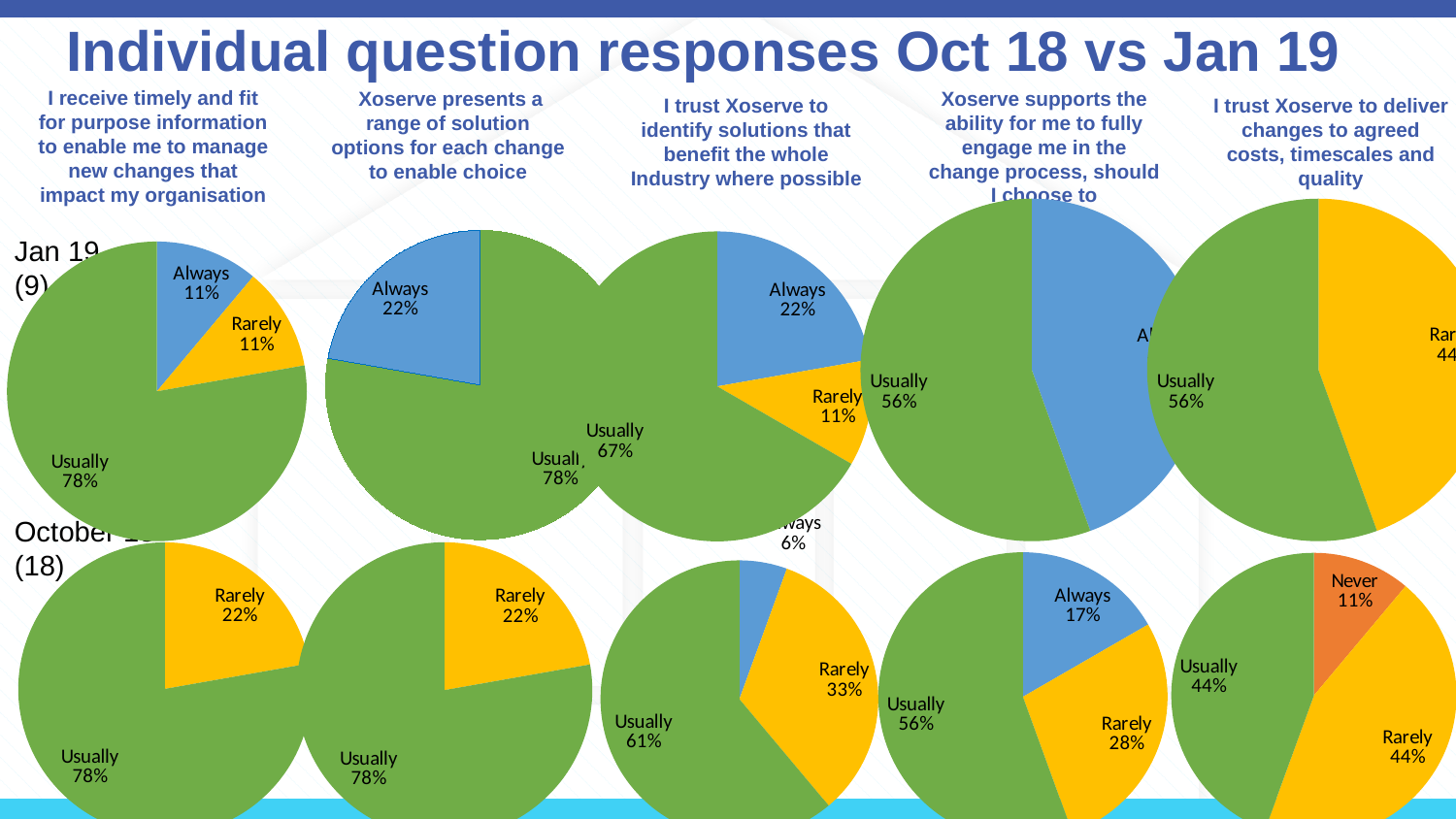
In the October 18 pie chart for 'I trust Xoserve to deliver changes to agreed costs, timescales and quality', what share is 'Never'? 11% In the October 18 pie chart for 'I trust Xoserve to identify solutions that benefit the whole Industry where possible', what share is 'Rarely'? 33% In the Jan 19 pie chart for 'Xoserve presents a range of solution options for each change to enable choice', what share is 'Always'? 22% What kind of charts are shown on the slide? Pie charts In the October 18 pie chart for 'I trust Xoserve to identify solutions that benefit the whole Industry where possible', which slice is the largest? Usually In the October 18 pie chart for 'I trust Xoserve to deliver changes to agreed costs, timescales and quality', which is larger, 'Usually' or 'Never'? Usually In the October 18 pie chart for 'Xoserve supports the ability for me to fully engage me in the change process, should I choose to', what is the difference between the 'Usually' and 'Rarely' shares? 28%